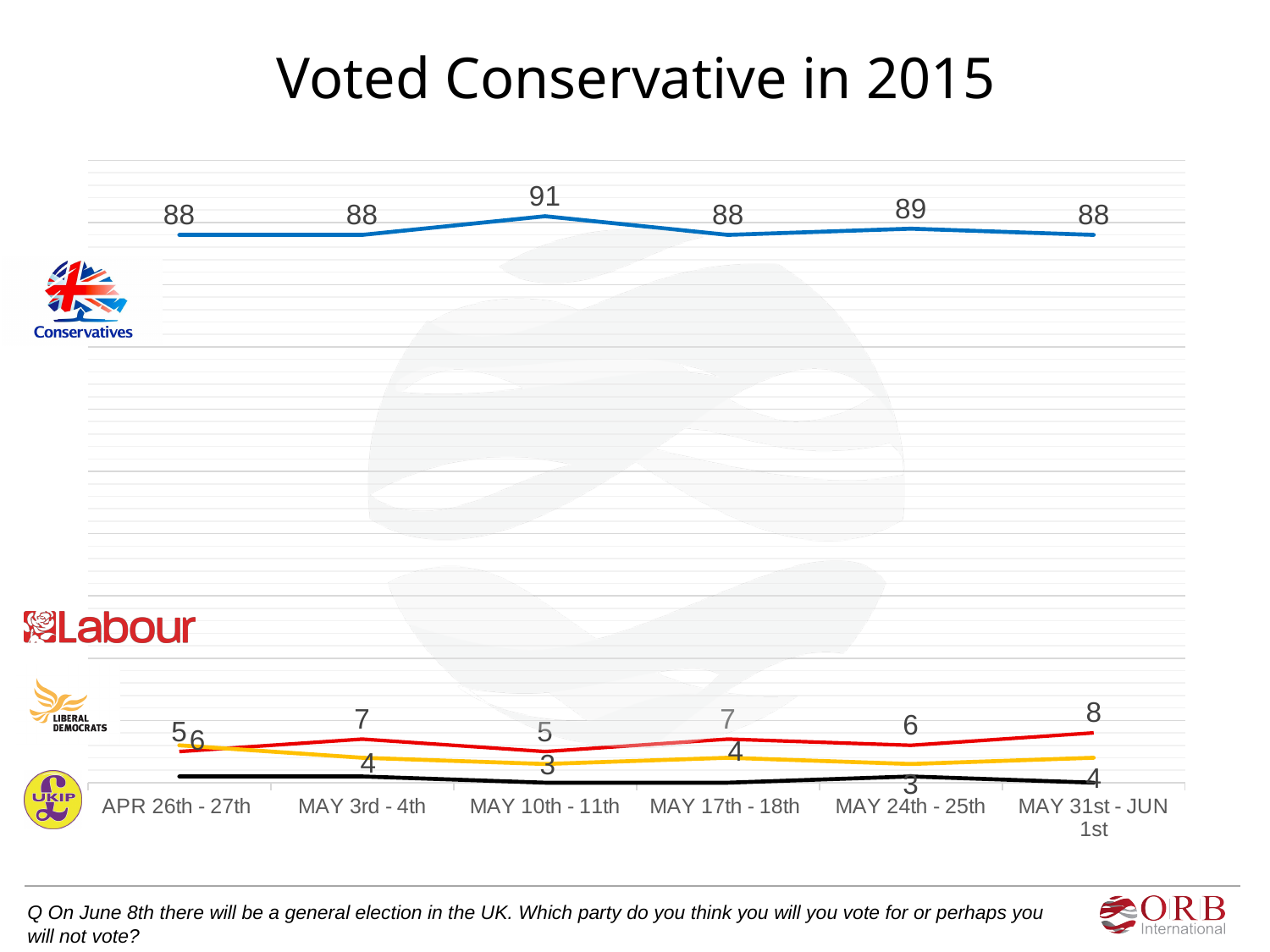
What value is shown for Labour (red line) at MAY 31st - JUN 1st? 8 By how much does the Labour value rise from MAY 24th - 25th to MAY 31st - JUN 1st? 2 What kind of chart is shown on the slide? Line chart What value is shown for the Conservatives (blue line) at MAY 10th - 11th? 91 What is the title of the chart? Voted Conservative in 2015 By how much does the Conservatives value at MAY 10th - 11th exceed its value at APR 26th - 27th? 3 How many lines (parties) are plotted on the chart? 4 What value is shown for Labour at MAY 3rd - 4th? 7 At which survey date does the Conservatives line reach its highest value? MAY 10th - 11th How many survey dates are shown along the x axis? 6 At MAY 10th - 11th, which is higher: Labour or the Liberal Democrats? Labour What value is shown for the Conservatives at MAY 24th - 25th? 89